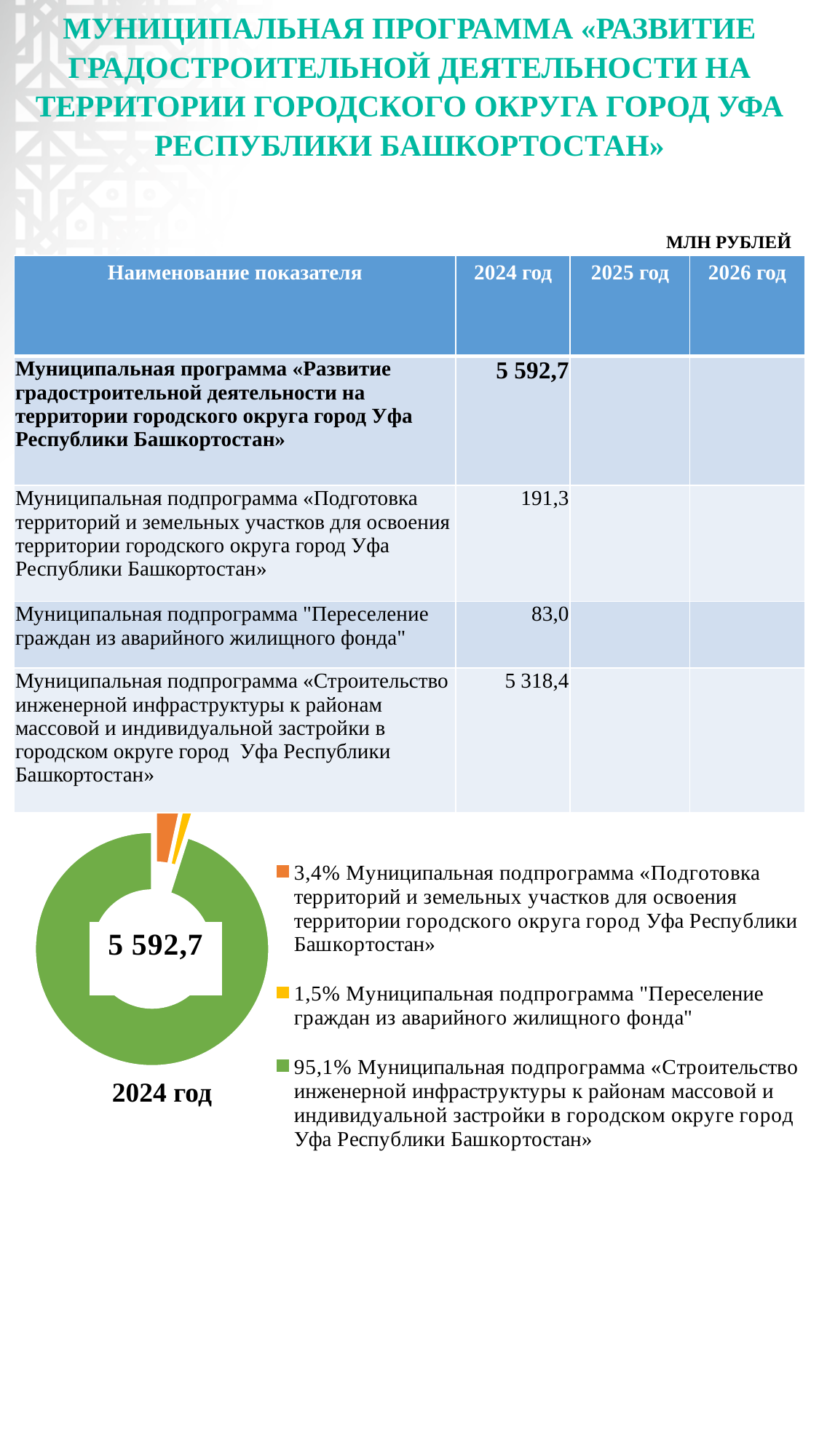
What share of the doughnut chart does the subprogram "Переселение граждан из аварийного жилищного фонда" take? 1,5% What year is labelled under the doughnut chart? 2024 год How many slices does the doughnut chart have? 3 Which subprogram has the smallest slice in the doughnut chart? Муниципальная подпрограмма "Переселение граждан из аварийного жилищного фонда" In the doughnut chart, which slice is larger: «Подготовка территорий...» or "Переселение граждан из аварийного жилищного фонда"? «Подготовка территорий...» What share of the doughnut chart does the subprogram «Подготовка территорий и земельных участков...» take? 3,4% What is the difference in percentage points between the 95,1% slice and the 3,4% slice in the doughnut chart? 91,7 What total value is printed in the centre of the doughnut chart? 5 592,7 How many entries does the legend of the doughnut chart list? 3 Which subprogram has the largest slice in the doughnut chart? Муниципальная подпрограмма «Строительство инженерной инфраструктуры к районам массовой и индивидуальной застройки в городском округе город Уфа Республики Башкортостан» What share of the doughnut chart does the subprogram «Строительство инженерной инфраструктуры...» take? 95,1% What kind of chart is shown at the bottom of the slide? Doughnut (pie) chart